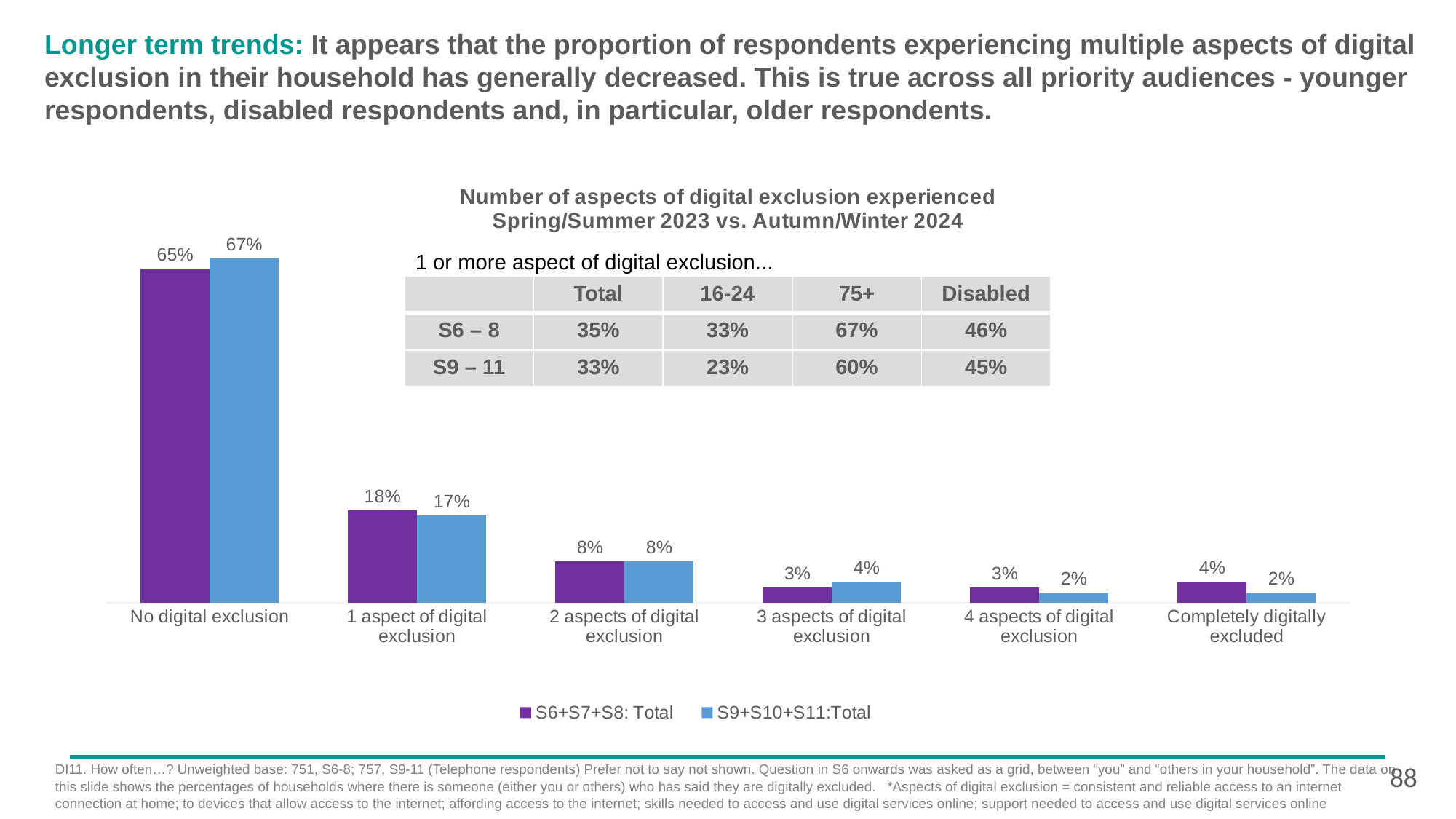
What is the value for '1 aspect of digital exclusion' in the S9+S10+S11:Total series? 17% What is the value for 'No digital exclusion' in the S6+S7+S8: Total series? 65% What is the title of the chart? Number of aspects of digital exclusion experienced Spring/Summer 2023 vs. Autumn/Winter 2024 For '4 aspects of digital exclusion', which series has the larger value, S6+S7+S8: Total or S9+S10+S11:Total? S6+S7+S8: Total How many series does the chart legend list? 2 What is the difference between the S9+S10+S11:Total and S6+S7+S8: Total values for 'No digital exclusion'? 2% What is the difference between the S6+S7+S8: Total and S9+S10+S11:Total values for 'Completely digitally excluded'? 2% What is the value for 'Completely digitally excluded' in the S6+S7+S8: Total series? 4% What kind of chart is shown on the slide? Bar chart Which category has the highest value in the S6+S7+S8: Total series? No digital exclusion What is the value for 'No digital exclusion' in the S9+S10+S11:Total series? 67% How many categories are shown on the x axis of the chart? 6